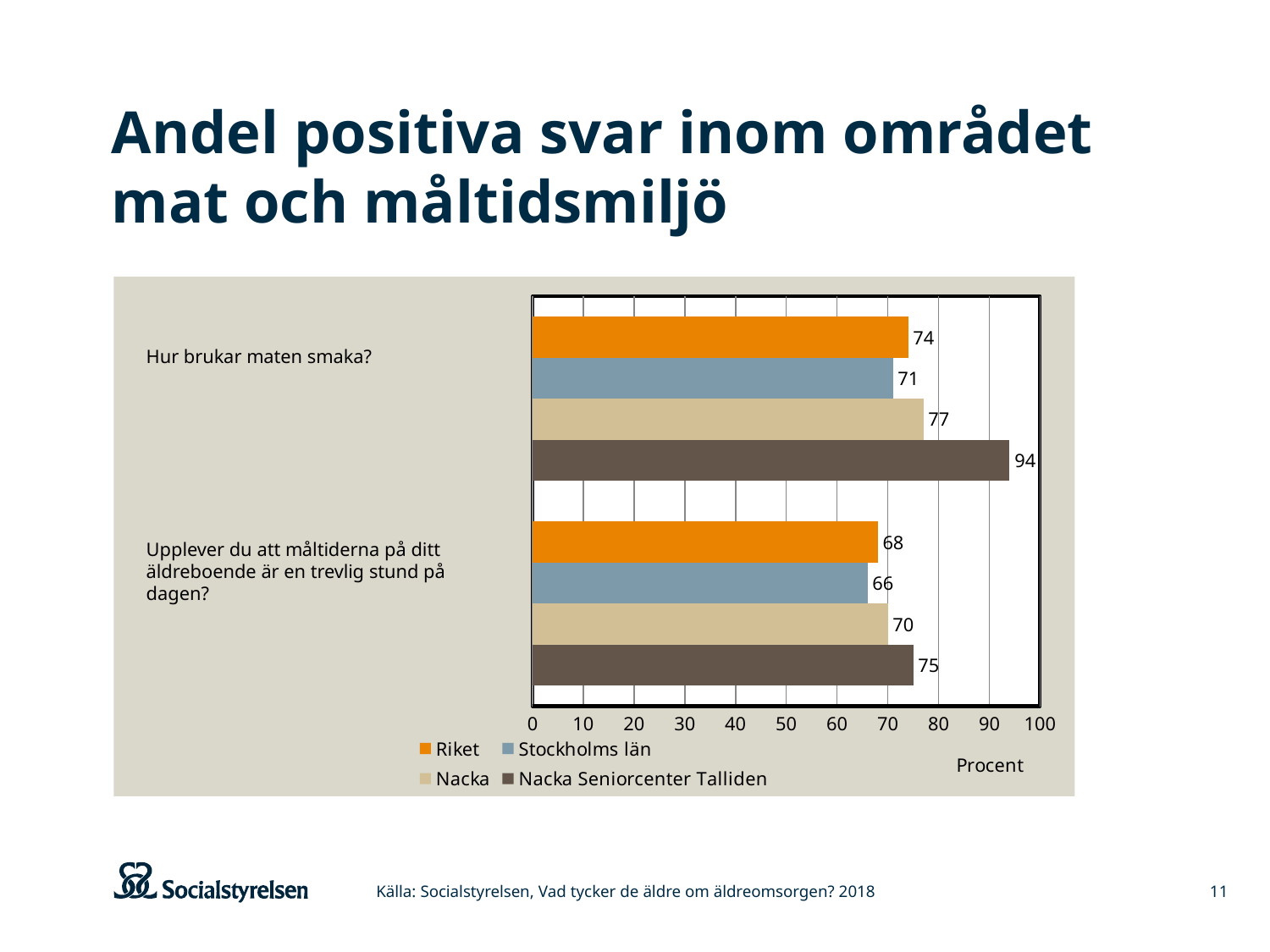
Which is larger for "Upplever du att måltiderna på ditt äldreboende är en trevlig stund på dagen?": Nacka or Nacka Seniorcenter Talliden? Nacka Seniorcenter Talliden What is the label on the horizontal axis of the chart? Procent What is the value for Riket for "Upplever du att måltiderna på ditt äldreboende är en trevlig stund på dagen?"? 68 What is the value for Stockholms län for "Hur brukar maten smaka?"? 71 What kind of chart is shown on the slide? Bar chart How many questions (categories) are shown on the chart? 2 What is the value for Nacka for "Upplever du att måltiderna på ditt äldreboende är en trevlig stund på dagen?"? 70 What is the value for Nacka Seniorcenter Talliden for "Hur brukar maten smaka?"? 94 Which series has the lowest value for "Upplever du att måltiderna på ditt äldreboende är en trevlig stund på dagen?"? Stockholms län How many series does the legend list? 4 What is the difference between Nacka Seniorcenter Talliden and Riket for "Hur brukar maten smaka?"? 20 Which series has the highest value for "Hur brukar maten smaka?"? Nacka Seniorcenter Talliden